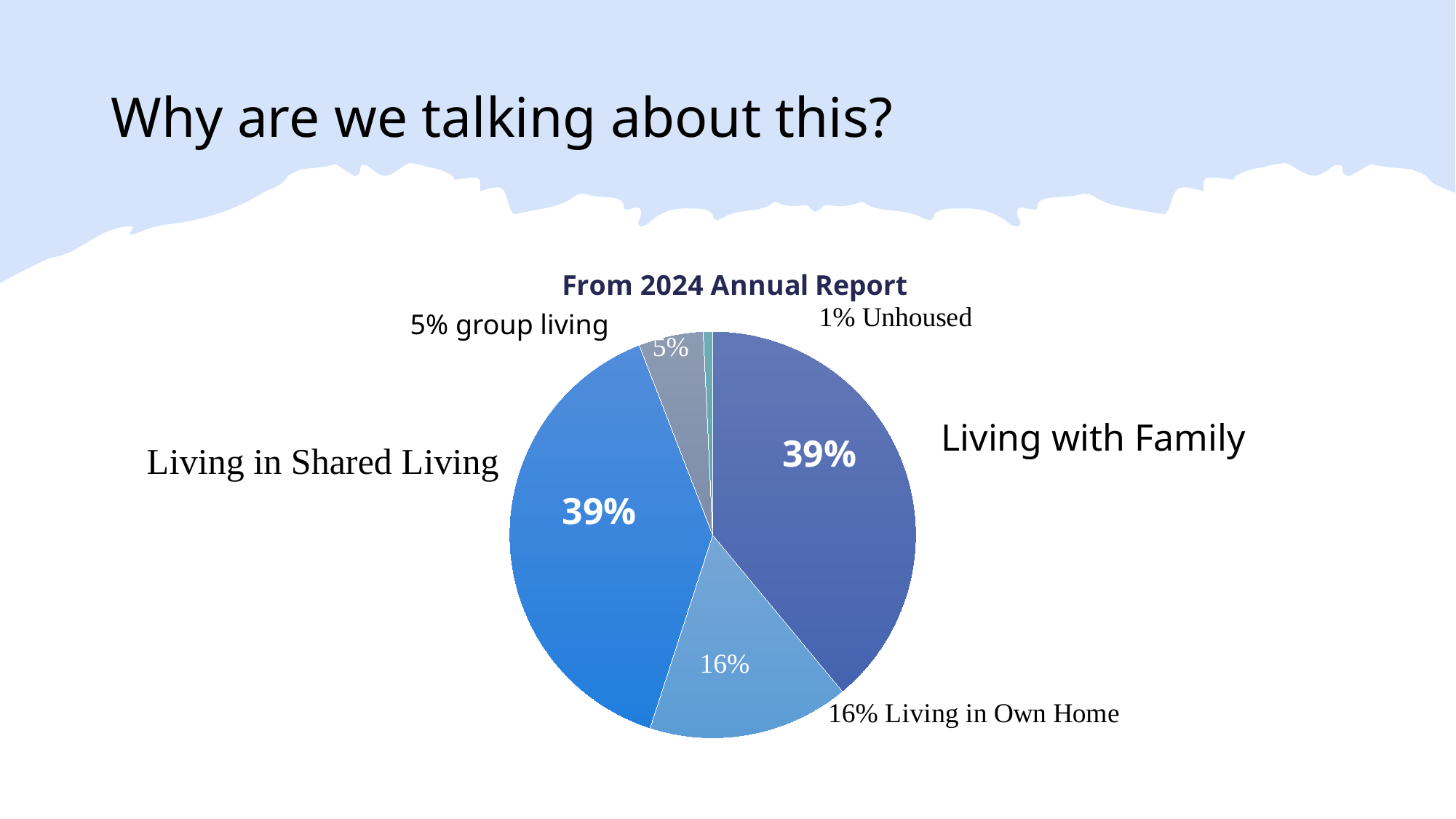
What is the difference between the Living in Shared Living share and the Living in Own Home share? 23% What percentage of the pie is Unhoused? 1% How many slices does the pie chart have? 5 Which category has the smallest slice of the pie? Unhoused What is the combined share of Living with Family and Living in Shared Living? 78% What share of the pie does Living in Shared Living represent? 39% Which is larger: Living with Family or Living in Own Home? Living with Family What percentage of the pie is group living? 5% What type of chart is shown on the slide? pie chart What is the title of the chart? From 2024 Annual Report What percentage of the pie is Living in Own Home? 16% What percentage of the pie is Living with Family? 39%